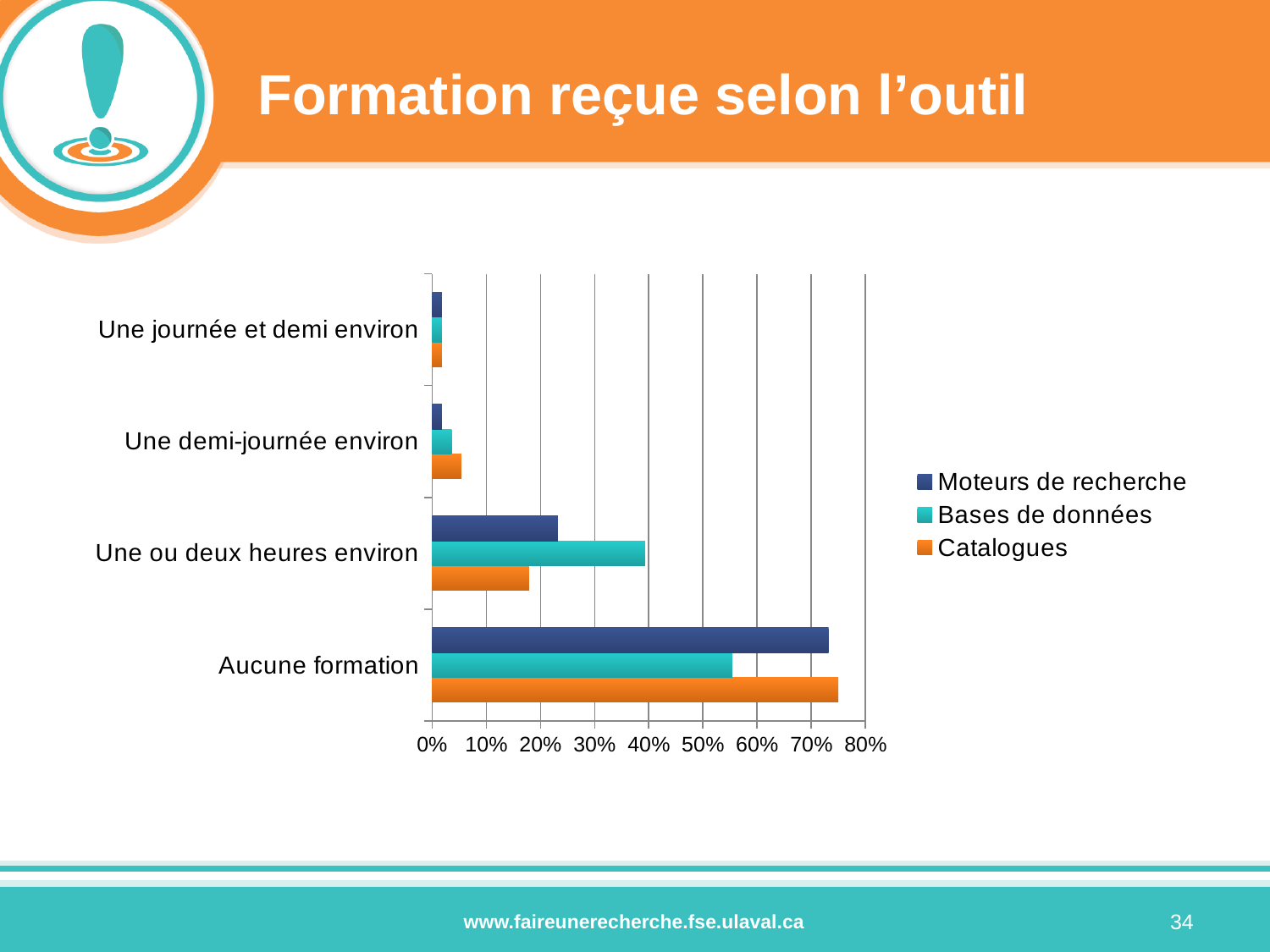
How many categories are shown on the vertical axis of the chart? 4 For the series Moteurs de recherche, which category has the highest value? Aucune formation How many series does the legend list? 3 Is the value for Bases de données in the category Une ou deux heures environ greater or less than 30%? greater For the series Bases de données, which category has the highest value? Aucune formation In the category Une ou deux heures environ, which is larger: Bases de données or Moteurs de recherche? Bases de données What kind of chart is shown on the slide? bar chart Is the value for Moteurs de recherche in the category Aucune formation greater or less than 70%? greater What is the title of the slide containing the chart? Formation reçue selon l'outil Which series is shown in orange in the legend? Catalogues Is the value for Bases de données in the category Aucune formation greater or less than 60%? less In the category Aucune formation, which is larger: Moteurs de recherche or Bases de données? Moteurs de recherche